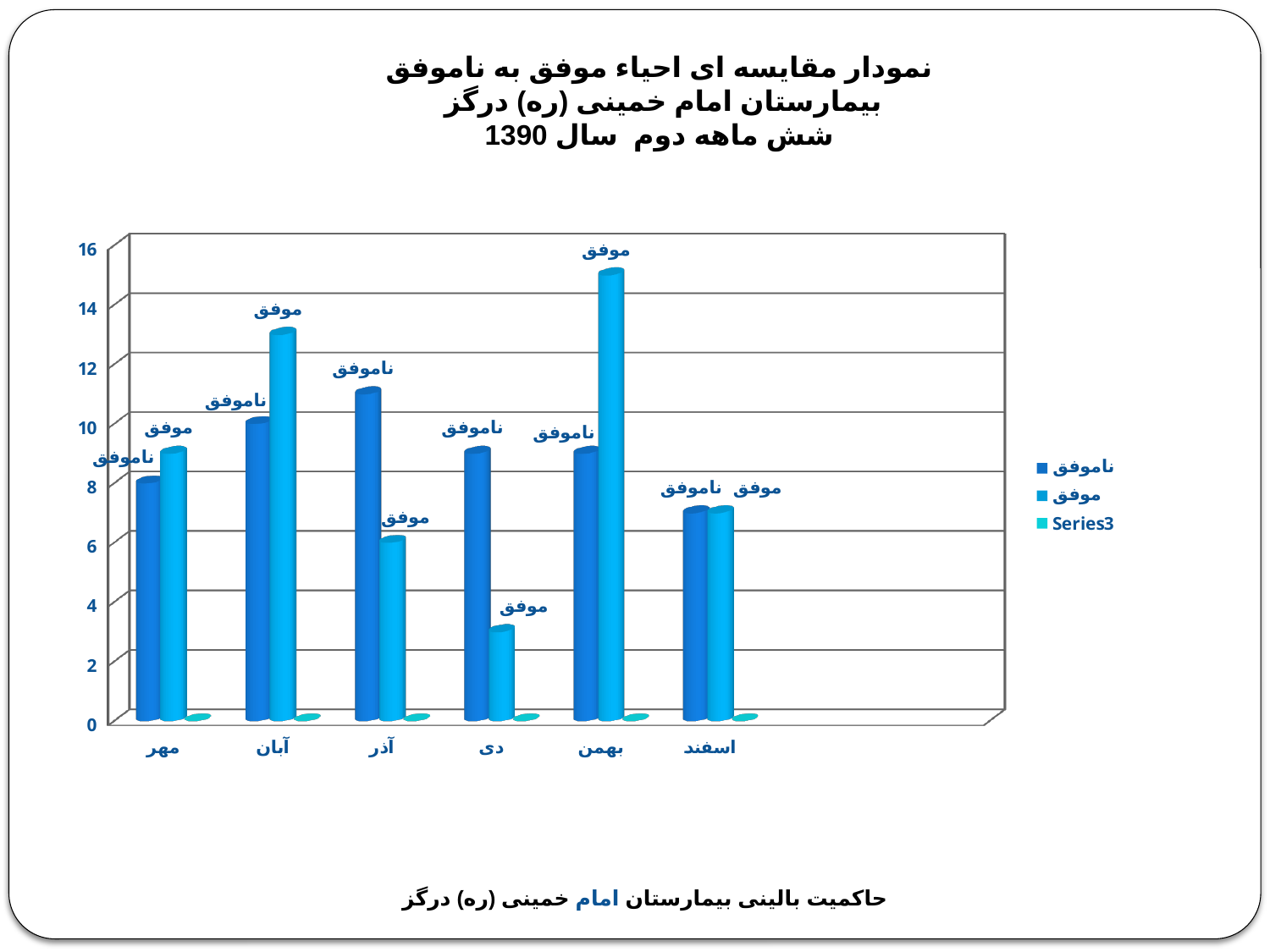
How many series does the legend list? 3 Which month has the lowest موفق bar? دی In آذر, which bar is taller, ناموفق or موفق? ناموفق Which month has the highest ناموفق bar? آذر Is the موفق value for بهمن greater or less than 14? greater Which month has the highest موفق bar? بهمن Is the موفق value for آبان greater or less than 12? greater What are the three entries in the legend? ناموفق, موفق, Series3 Is the موفق value for دی greater or less than 4? less What kind of chart is shown on the slide? bar chart How many months (categories) are shown on the x axis? 6 In بهمن, which bar is taller, ناموفق or موفق? موفق